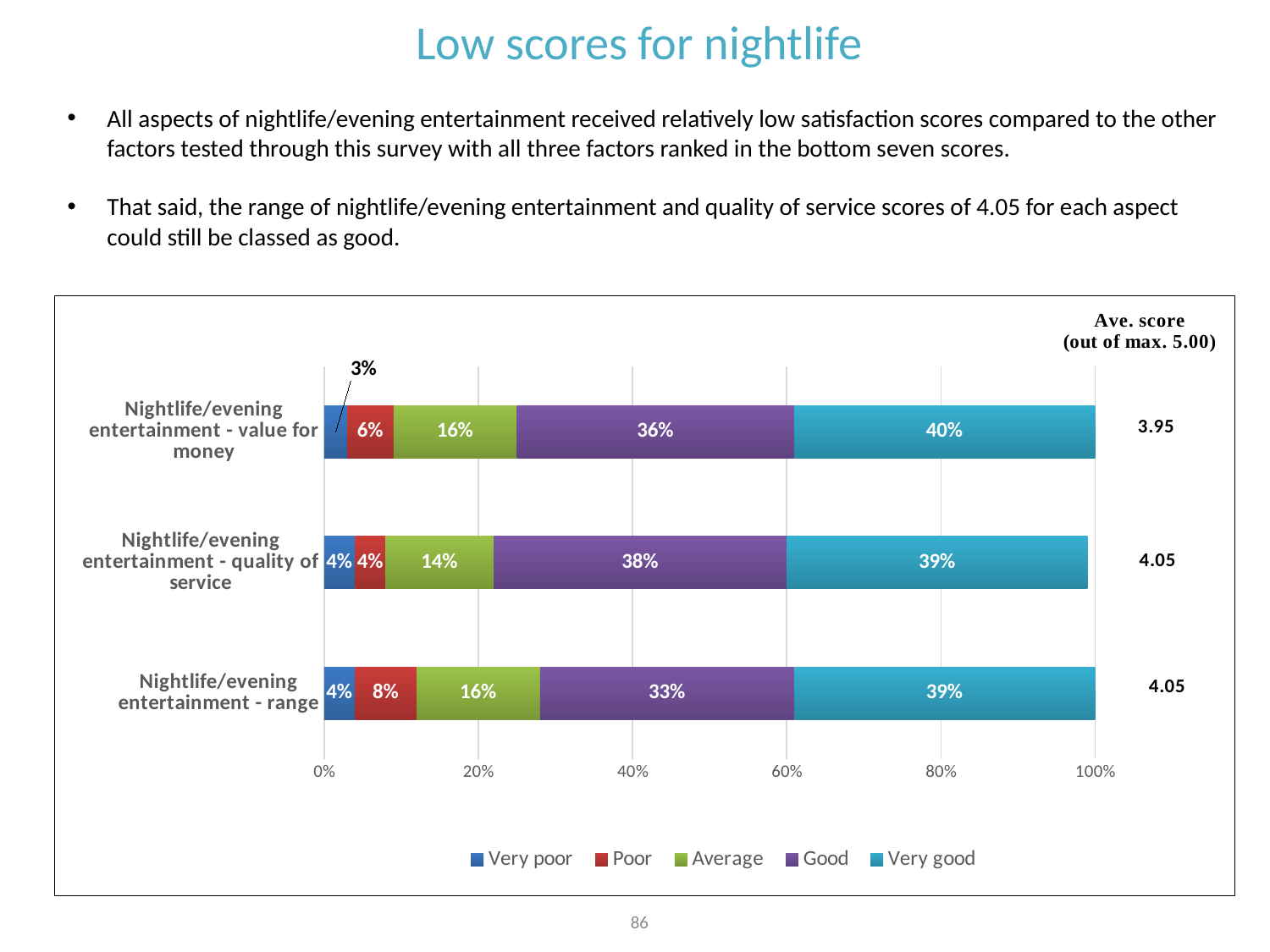
What percentage rated nightlife/evening entertainment - range as 'Poor'? 8% What percentage of respondents rated nightlife/evening entertainment - value for money as 'Very good'? 40% What is the average score (out of max. 5.00) shown for nightlife/evening entertainment - value for money? 3.95 Is the 'Very good' percentage larger for value for money or for range? Value for money Which category has the lowest 'Poor' percentage? Nightlife/evening entertainment - quality of service How many series does the legend list? 5 What percentage rated nightlife/evening entertainment - quality of service as 'Average'? 14% What type of chart is shown on the slide? Stacked bar chart What is the difference between the 'Good' percentages for quality of service and range? 5% Which category has the highest 'Good' percentage? Nightlife/evening entertainment - quality of service How many categories are shown in the chart? 3 What is the 'Very poor' percentage for nightlife/evening entertainment - value for money? 3%